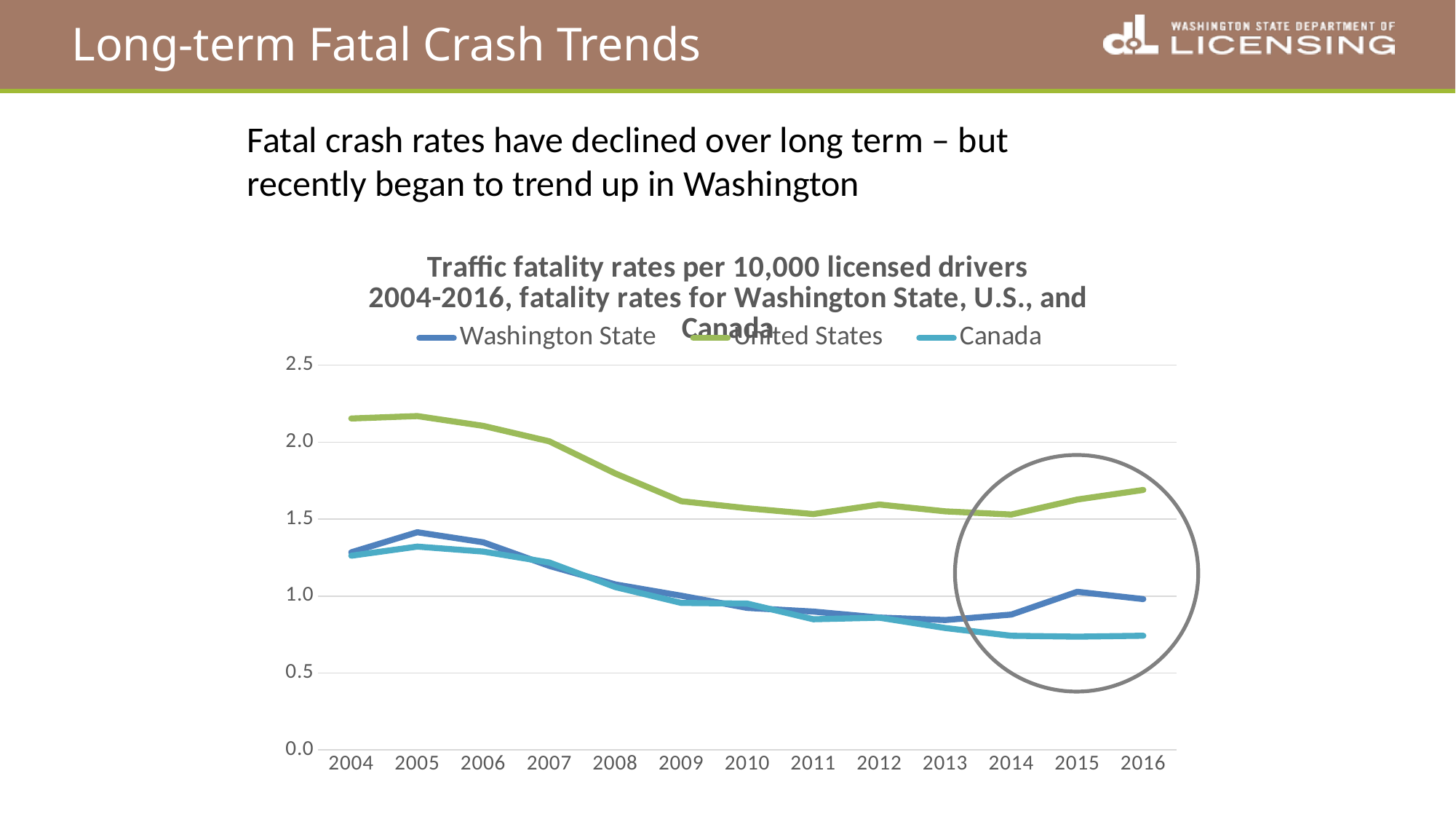
How many series does the legend list? 3 Is the value for Canada in 2016 greater or less than 1.0? less What kind of chart is shown on the slide? line chart How many years are plotted along the x axis? 13 Is the value for United States in 2004 greater or less than 2.0? greater Is the value for United States in 2016 greater or less than 1.5? greater Which series is drawn in green? United States Does the United States fatality rate rise or fall from 2004 to 2014? fall In 2016, which is larger: the value for Washington State or the value for Canada? Washington State Which series has the lowest fatality rate in 2016? Canada Which series has the highest fatality rate in 2004? United States